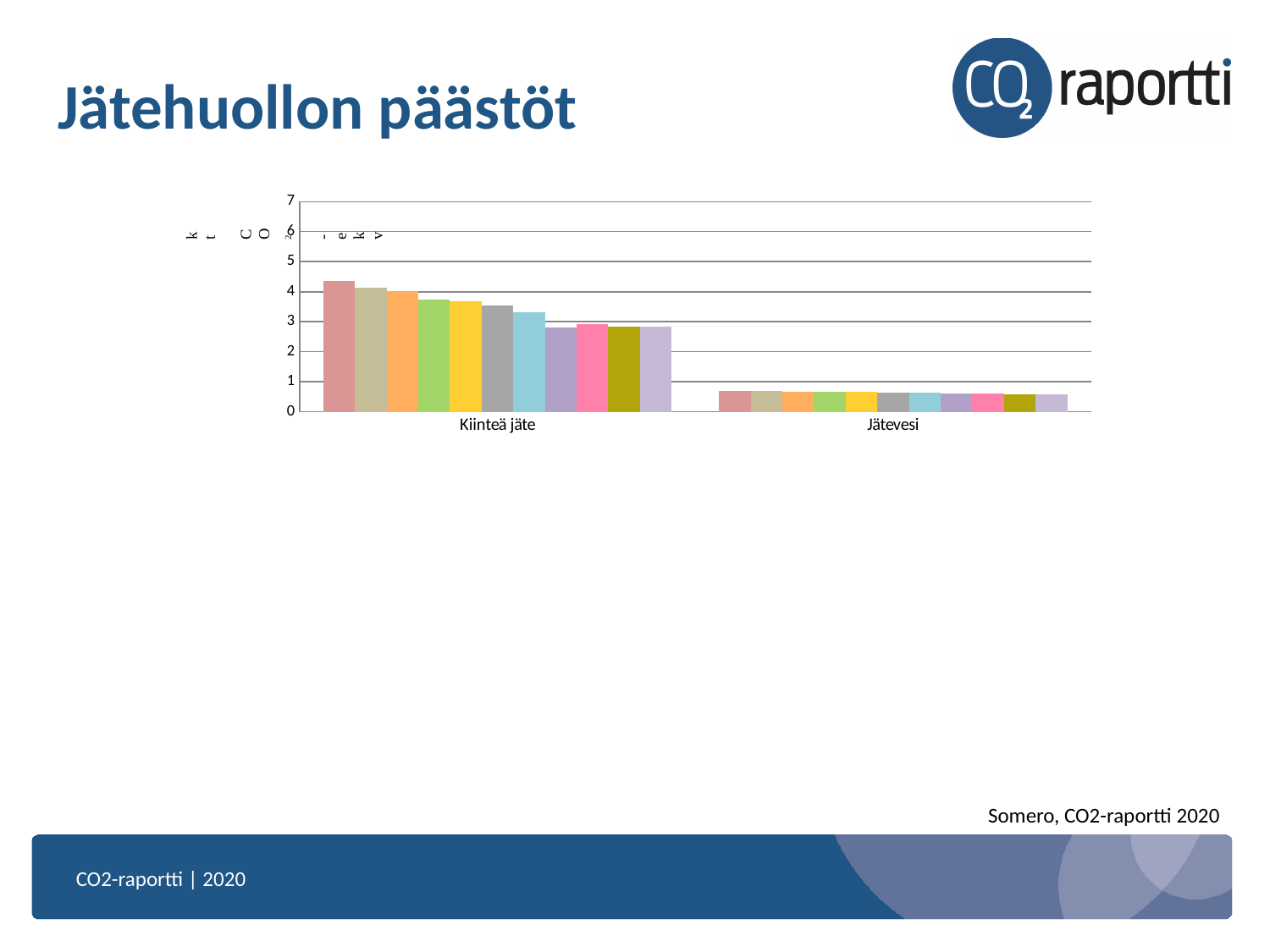
What is the title of the slide containing the chart? Jätehuollon päästöt Which category has the lowest values in the chart? Jätevesi What kind of chart is shown on the slide? bar chart Are the values of the bars for Jätevesi greater or less than 1? less Are the values of the bars for Kiinteä jäte greater or less than 2? greater How many bars are plotted for the Kiinteä jäte category? 11 Is the value of the first (leftmost) bar for Kiinteä jäte greater or less than 4? greater Do the bars for Kiinteä jäte rise or fall from left to right? fall Which category has the higher bars, Kiinteä jäte or Jätevesi? Kiinteä jäte How many categories are shown on the x axis of the chart? 2 Which category has the highest values in the chart? Kiinteä jäte What are the two categories on the x axis of the chart? Kiinteä jäte and Jätevesi